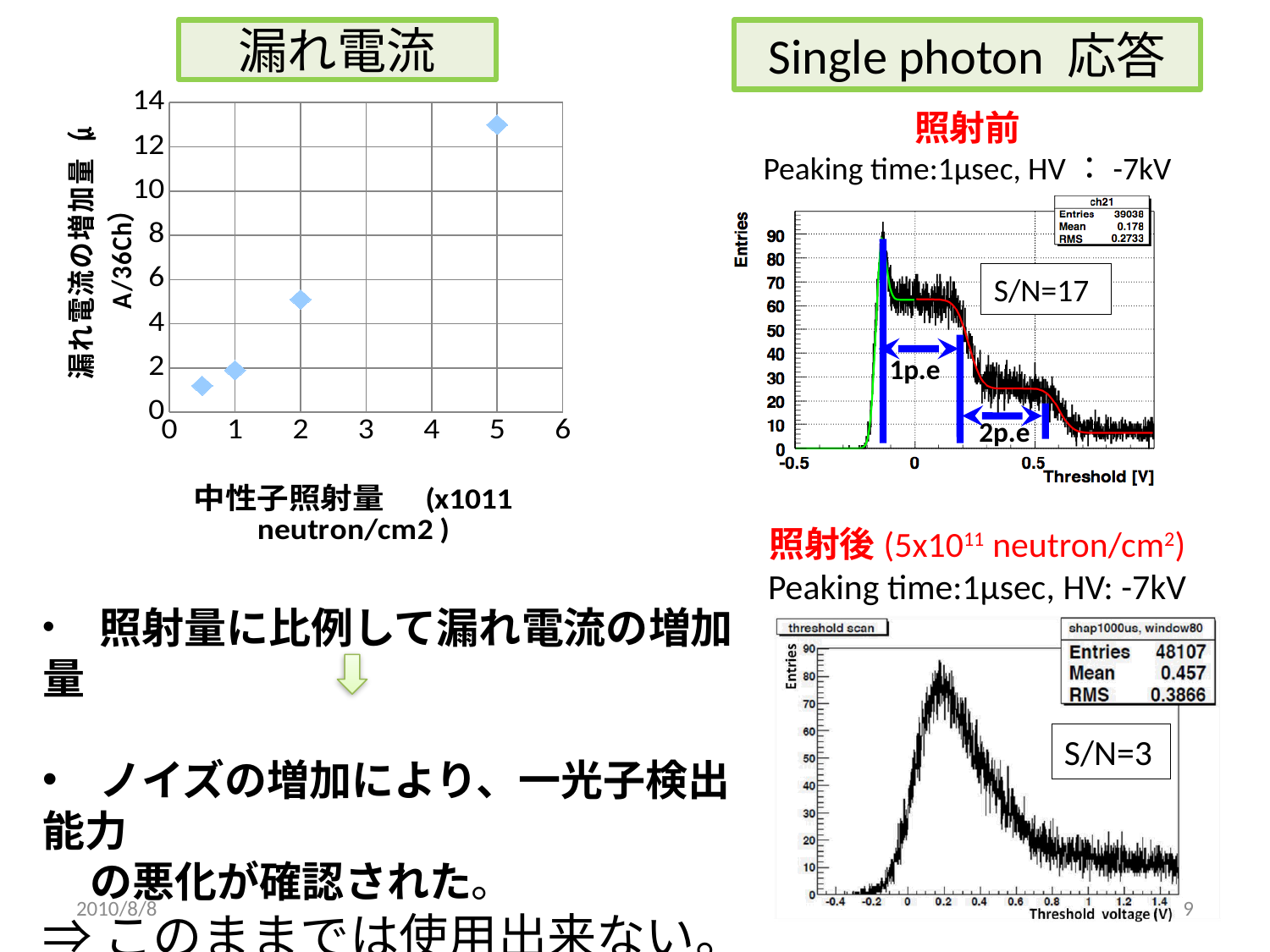
In the 漏れ電流 chart on the left, at which x-axis value is the plotted point highest? 5 What is the S/N value shown on the 照射後 (after irradiation) histogram on the right? S/N=3 In the 漏れ電流 chart on the left, is the value of the point at x = 5 greater or less than 12? greater In the 漏れ電流 chart on the left, is the value of the point at x = 2 greater or less than 4? greater In the 漏れ電流 chart on the left, at which x-axis value is the plotted point lowest? 0.5 In the 漏れ電流 chart on the left, is the value of the point at x = 0.5 greater or less than 2? less What kind of chart is the 漏れ電流 chart on the left of the slide? scatter chart How many data points are plotted in the 漏れ電流 chart on the left? 4 In the 漏れ電流 chart on the left, do the values rise or fall as the neutron dose on the x axis increases? rise What is the number of Entries shown in the statistics box of the 照射後 (after irradiation) histogram? 48107 What is the S/N value shown on the 照射前 (before irradiation) histogram on the right? S/N=17 In the 漏れ電流 chart on the left, which point has the larger value: the one at x = 1 or the one at x = 2? x = 2